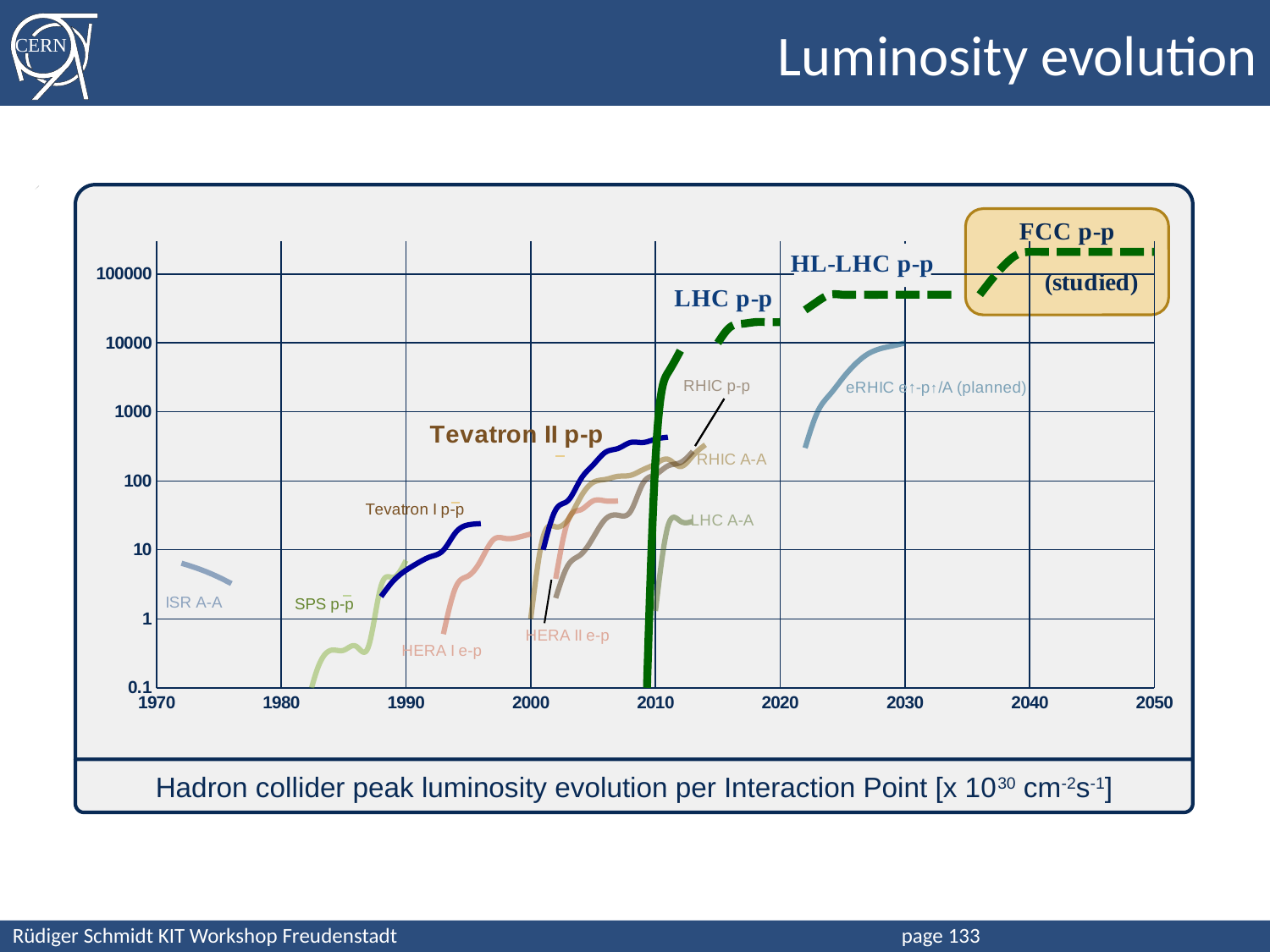
Which collider curve starts at the lowest luminosity on the chart? SPS p-p̄ Is the luminosity shown for HL-LHC p-p greater or less than 10000? greater What is the title printed below the chart? Hadron collider peak luminosity evolution per Interaction Point [x 10^30 cm^-2 s^-1] Which collider curve reaches the highest luminosity on the chart? FCC p-p What kind of chart is shown on the slide? line chart Which reaches a higher luminosity, LHC p-p or Tevatron II p-p? LHC p-p What range of years does the x axis cover? 1970 to 2050 Does the LHC p-p luminosity curve rise or fall over time? rise Is the peak luminosity shown for HERA I e-p greater or less than 100? less Is the luminosity shown for ISR A-A greater or less than 10? less